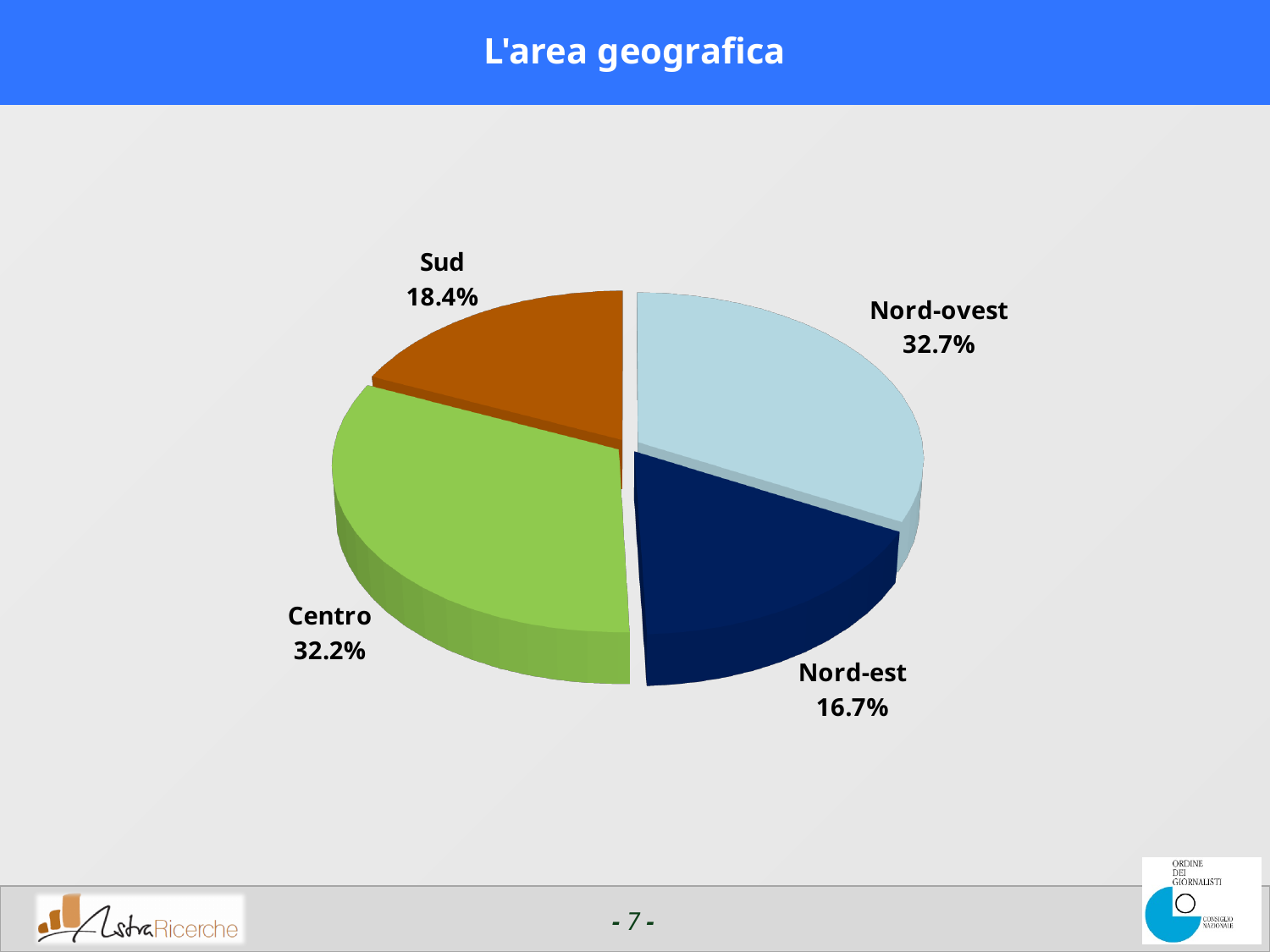
What is the value shown for Centro? 32.2% What share of the pie does Sud represent? 18.4% Which area has the smallest share of the pie? Nord-est How many slices does the pie chart have? 4 What is the value shown for Nord-ovest? 32.7% What is the difference in percentage points between Centro and Sud? 13.8 What is the value shown for Nord-est? 16.7% What is the difference in percentage points between Nord-ovest and Nord-est? 16.0 Which area has the largest share of the pie? Nord-ovest What is the title of the chart? L'area geografica Which is larger, the share for Sud or the share for Nord-est? Sud What kind of chart is shown on the slide? Pie chart